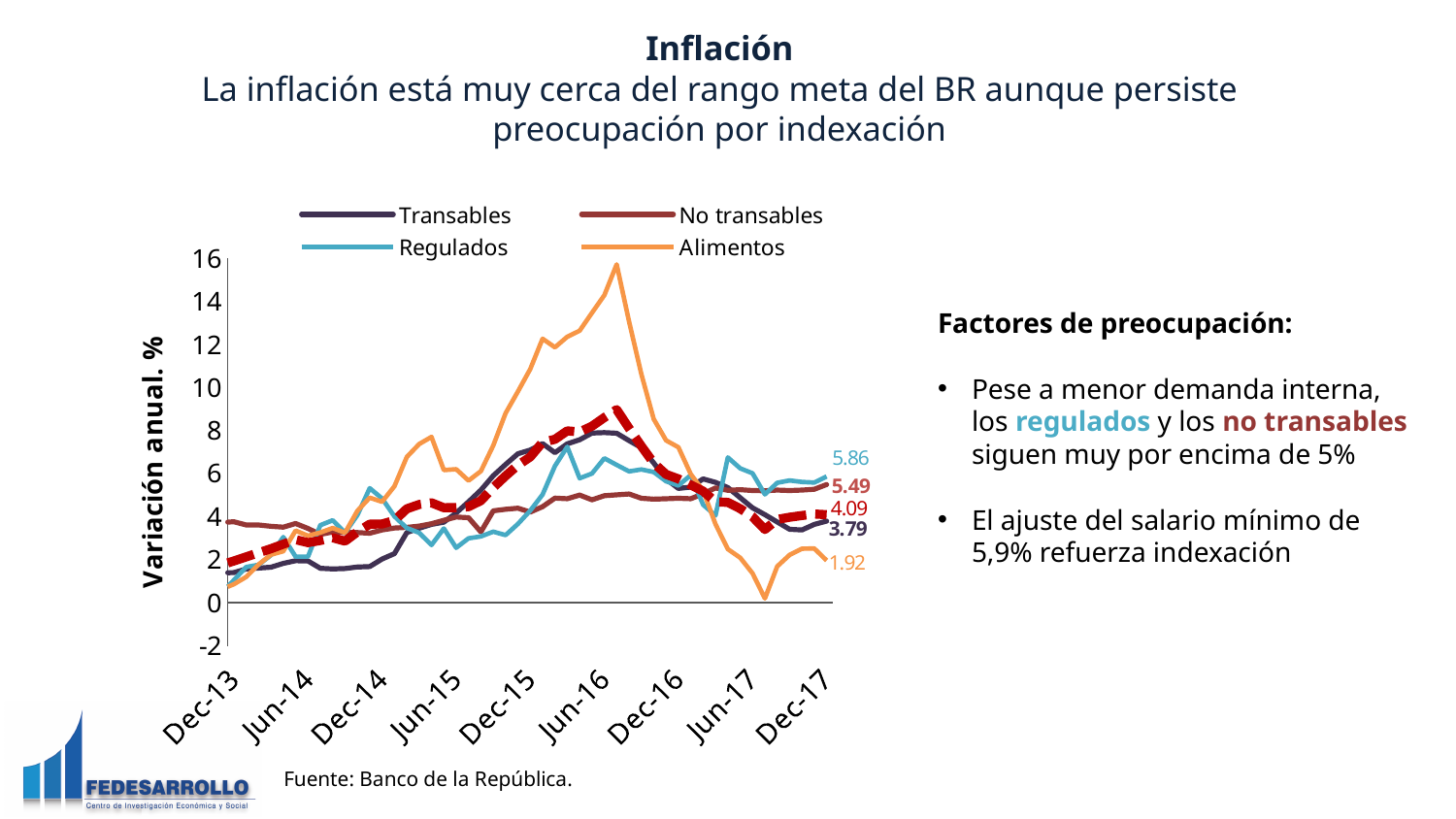
What is the value labelled for the Transables series at the end of the chart? 3.79 How many series are listed in the chart legend? 4 What is the difference between the end-of-chart values of Regulados (5.86) and Alimentos (1.92)? 3.94 What is the value labelled for the No transables series at the end of the chart? 5.49 Does the Alimentos series rise or fall between Jun-16 and Dec-17? Fall Which series has the lowest labelled value at the end of the chart? Alimentos Which series has the highest labelled value at the end of the chart? Regulados What is the value labelled for the Alimentos series at the end of the chart? 1.92 What is the value labelled for the Regulados series at the end of the chart (Dec-17)? 5.86 At the end of the chart, which is larger: the Regulados value or the No transables value? Regulados What type of chart is shown on the slide? Line chart Is the peak value of the Alimentos series (around Jun-16) greater or less than 14? greater